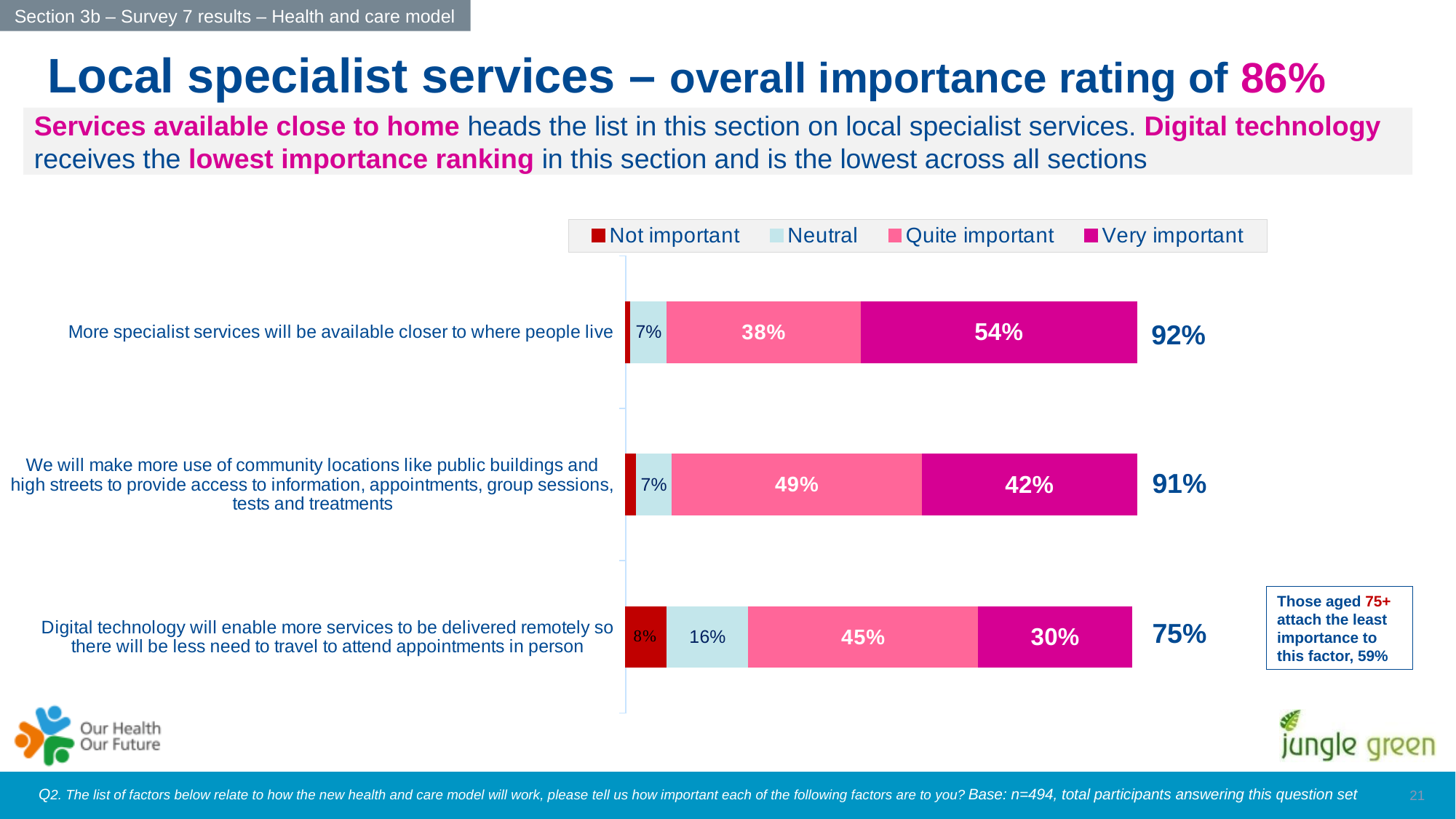
Which is larger for 'We will make more use of community locations...': the Quite important value or the Very important value? Quite important Which factor has the lowest Very important value? Digital technology will enable more services to be delivered remotely so there will be less need to travel to attend appointments in person What is the Neutral value for 'Digital technology will enable more services to be delivered remotely...'? 16% What is the Not important value for 'Digital technology will enable more services to be delivered remotely...'? 8% How many series does the legend list? 4 What is the Very important value for 'More specialist services will be available closer to where people live'? 54% How many factors (categories) are plotted in the chart? 3 Which factor has the highest Very important value? More specialist services will be available closer to where people live What kind of chart is shown on the slide? Stacked bar chart What is the combined Quite important and Very important share for 'Digital technology will enable more services to be delivered remotely...'? 75% What is the difference between the Very important values for 'More specialist services will be available closer to where people live' and 'Digital technology will enable more services to be delivered remotely...'? 24% What is the Quite important value for 'We will make more use of community locations like public buildings and high streets...'? 49%